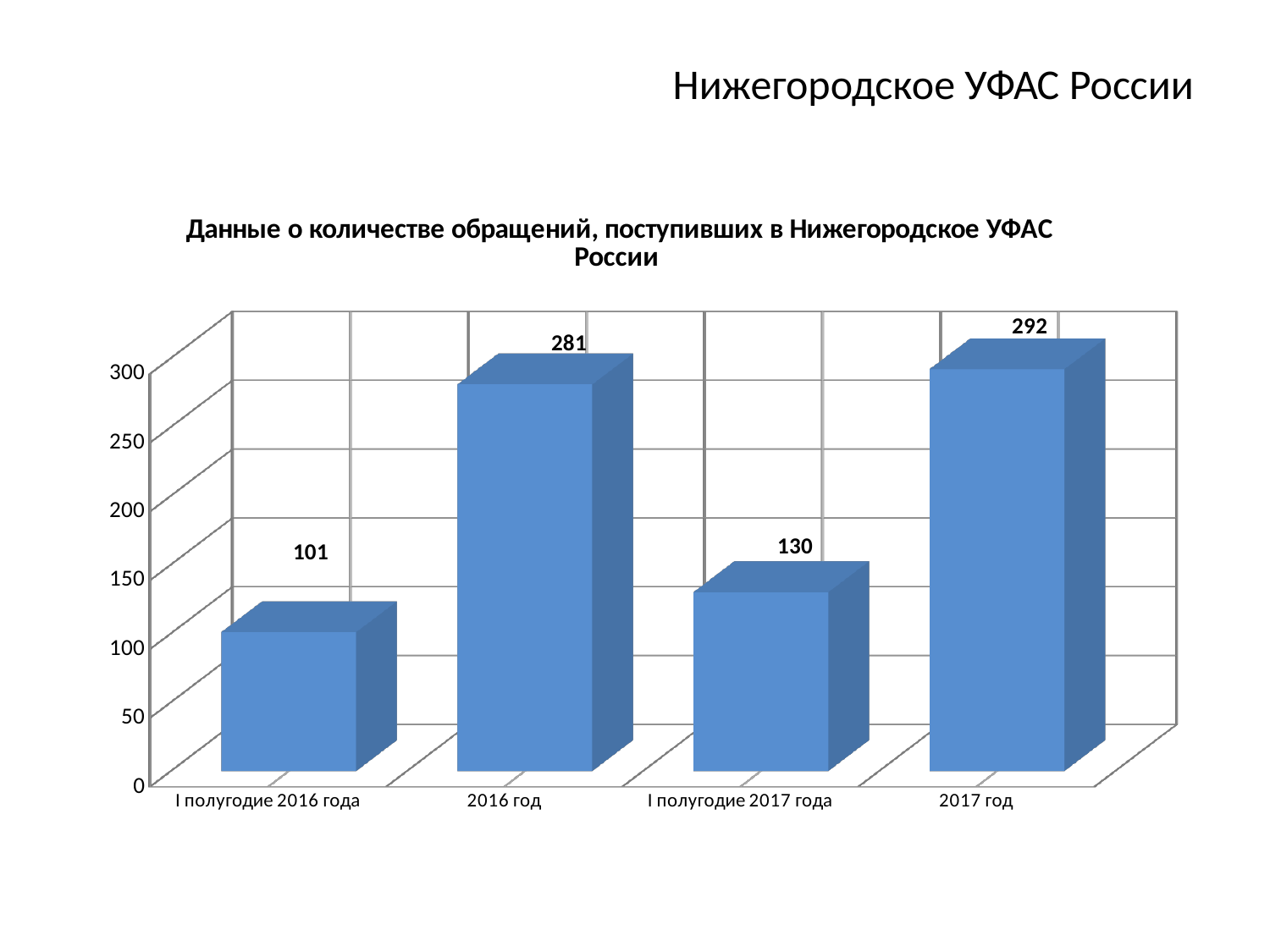
What is the title of the chart? Данные о количестве обращений, поступивших в Нижегородское УФАС России What is the value for I полугодие 2017 года? 130 How many categories are shown on the x axis? 4 Which category has the lowest value? I полугодие 2016 года Which is larger, the value for I полугодие 2017 года or the value for I полугодие 2016 года? I полугодие 2017 года What is the value for I полугодие 2016 года? 101 Is the value for 2016 год greater or less than 250? greater What kind of chart is shown on the slide? bar chart What is the difference between the values for 2017 год and 2016 год? 11 Which category has the highest value? 2017 год What is the value for 2016 год? 281 What is the difference between the values for I полугодие 2017 года and I полугодие 2016 года? 29